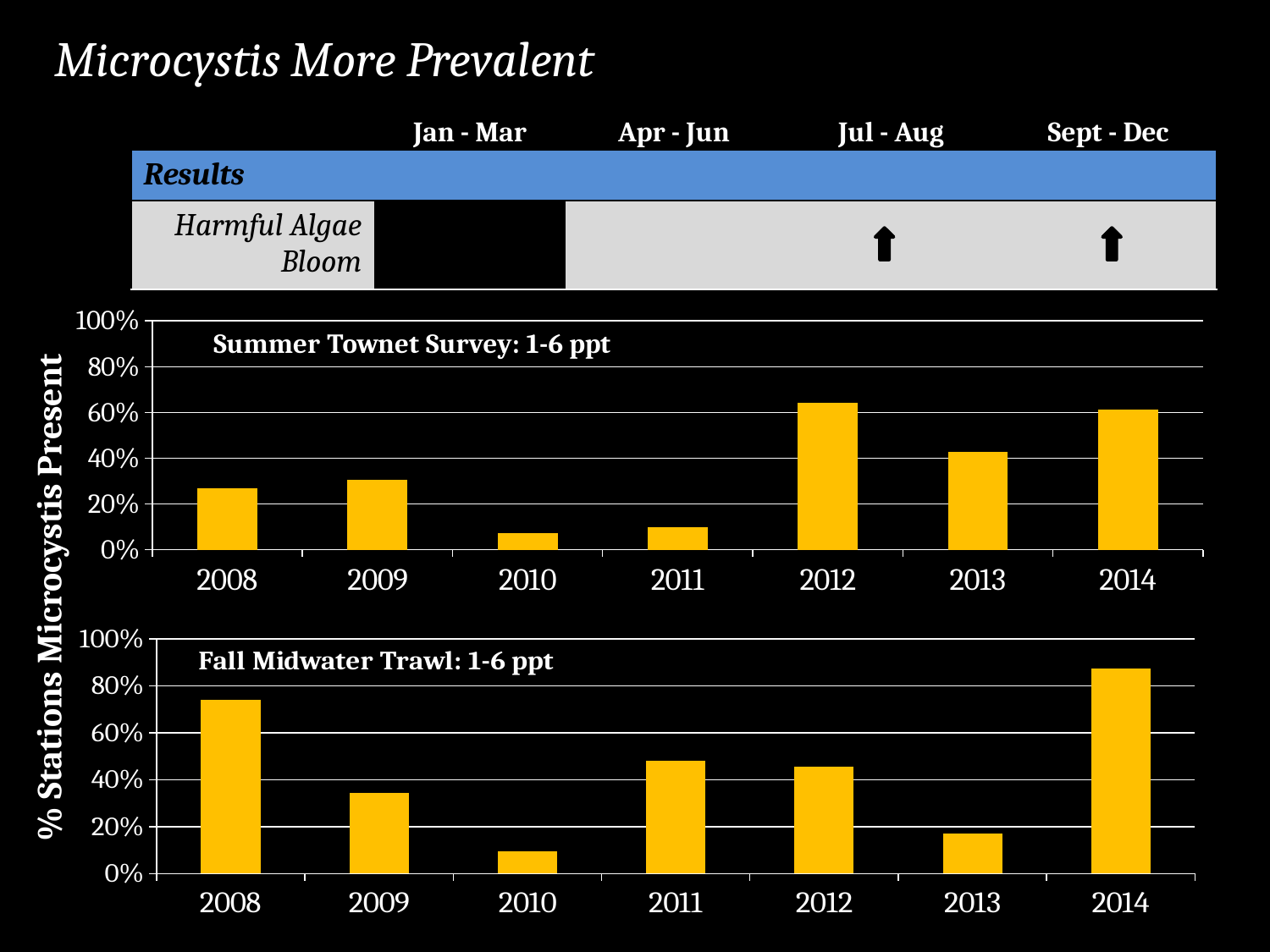
In the Summer Townet Survey: 1-6 ppt chart, is the value for 2012 greater or less than 60%? greater How many years are shown on the x axis of the Fall Midwater Trawl: 1-6 ppt chart? 7 In the Fall Midwater Trawl: 1-6 ppt chart, is the value for 2013 greater or less than 20%? less In the Summer Townet Survey: 1-6 ppt chart, which year has the lowest value? 2010 In the Summer Townet Survey: 1-6 ppt chart, which year has the highest value? 2012 In the Fall Midwater Trawl: 1-6 ppt chart, which year has the larger value, 2008 or 2009? 2008 What is the y-axis label shared by the two charts? % Stations Microcystis Present What kind of chart is the Summer Townet Survey: 1-6 ppt chart? bar chart In the Fall Midwater Trawl: 1-6 ppt chart, which year has the lowest value? 2010 In the Summer Townet Survey: 1-6 ppt chart, is the value for 2011 greater or less than 20%? less In the Fall Midwater Trawl: 1-6 ppt chart, which year has the highest value? 2014